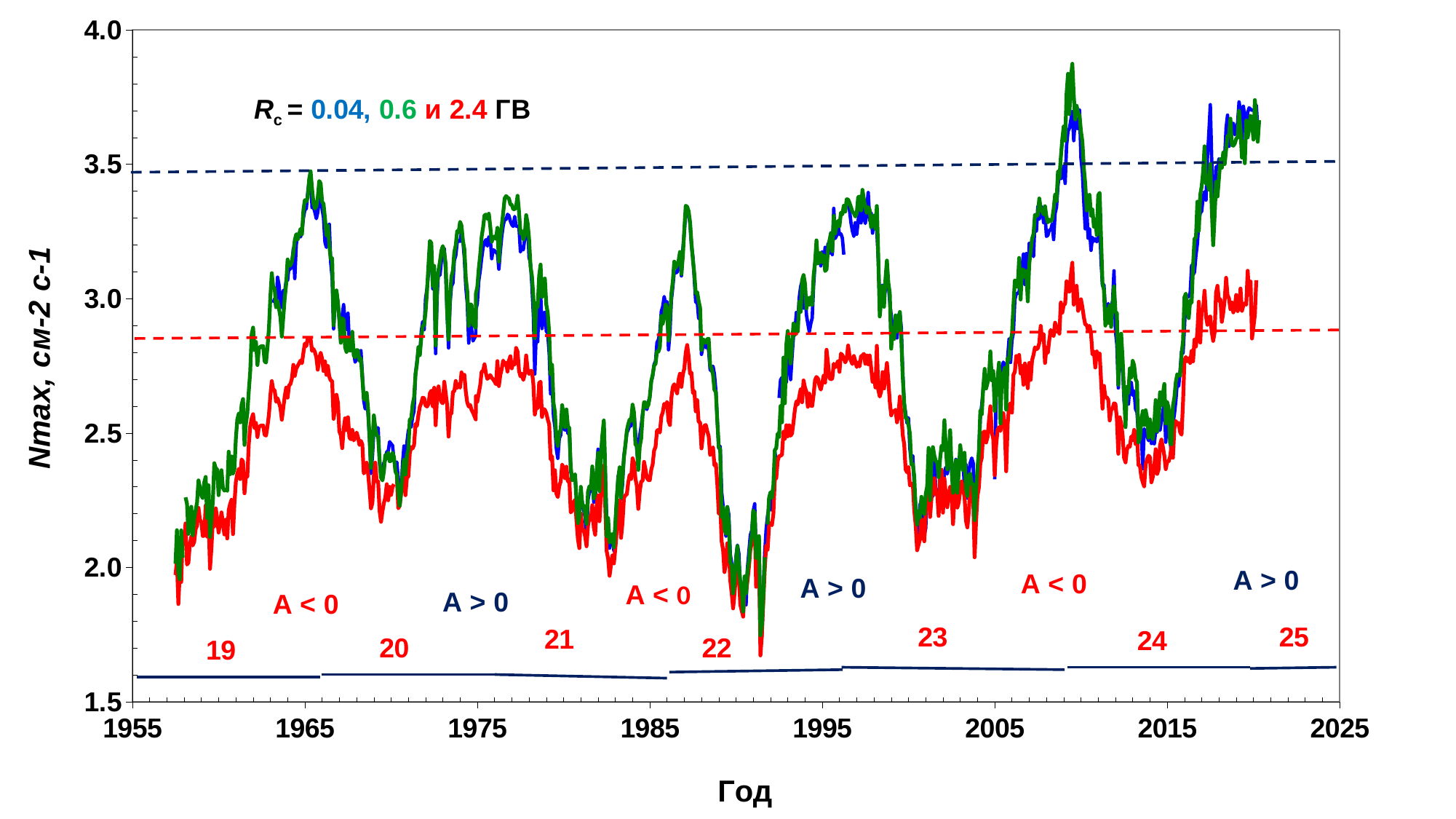
How many data series (Rc values) are plotted on the chart? 3 What kind of chart is shown on the slide? line chart Is the value of the red line at its 2009 peak greater or less than 3.5? less Which colour corresponds to Rc = 2.4 ГВ? red What is the label of the x axis? Год Around 2009, which line has the larger value, the green line or the red line? green line Is the peak value of the blue line around 1965 greater or less than 3.0? greater Is the peak value of the green line around 2009 greater or less than 3.5? greater Which of the three series lies lowest on the chart over the whole period? red (Rc = 2.4 ГВ) How many solar cycle numbers (19 to 25) are marked along the bottom of the chart? 7